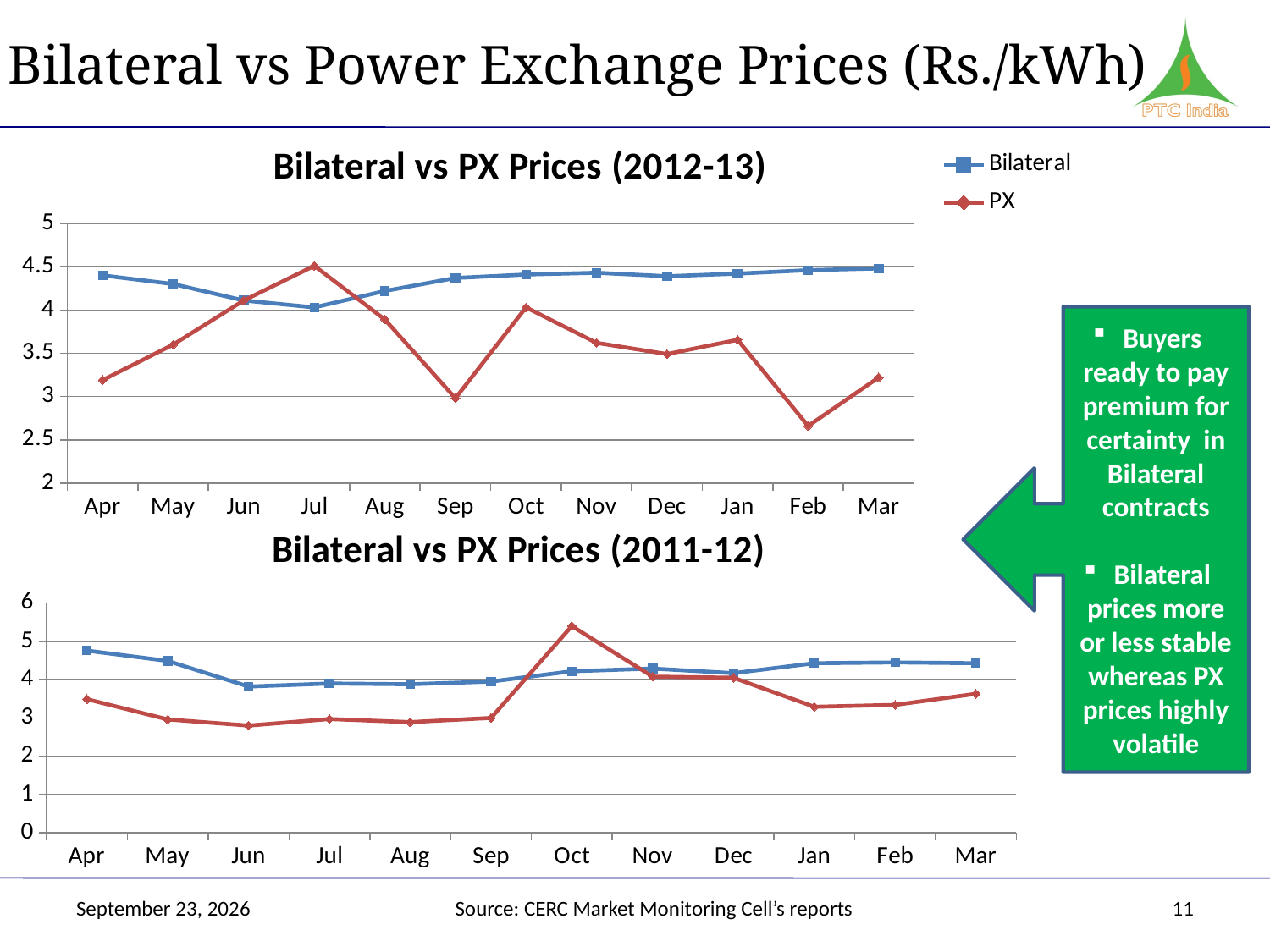
What kind of chart is the 'Bilateral vs PX Prices (2012-13)' chart? line chart In the 'Bilateral vs PX Prices (2012-13)' chart, in which month is the PX price lowest? Feb In the 'Bilateral vs PX Prices (2011-12)' chart, is the PX value for Oct greater or less than 5? greater What are the two series named in the legend? Bilateral and PX In the 'Bilateral vs PX Prices (2012-13)' chart, how many months are plotted on the x axis? 12 How many series does the legend list for the charts? 2 In the 'Bilateral vs PX Prices (2011-12)' chart, which series has the higher value in Apr, Bilateral or PX? Bilateral In the 'Bilateral vs PX Prices (2012-13)' chart, is the Bilateral value for Apr greater or less than 4? greater In the 'Bilateral vs PX Prices (2012-13)' chart, is the PX value for Feb greater or less than 3? less In the 'Bilateral vs PX Prices (2011-12)' chart, in which month is the PX price highest? Oct In the 'Bilateral vs PX Prices (2011-12)' chart, in which month is the Bilateral price highest? Apr In the 'Bilateral vs PX Prices (2012-13)' chart, in which month is the PX price highest? Jul